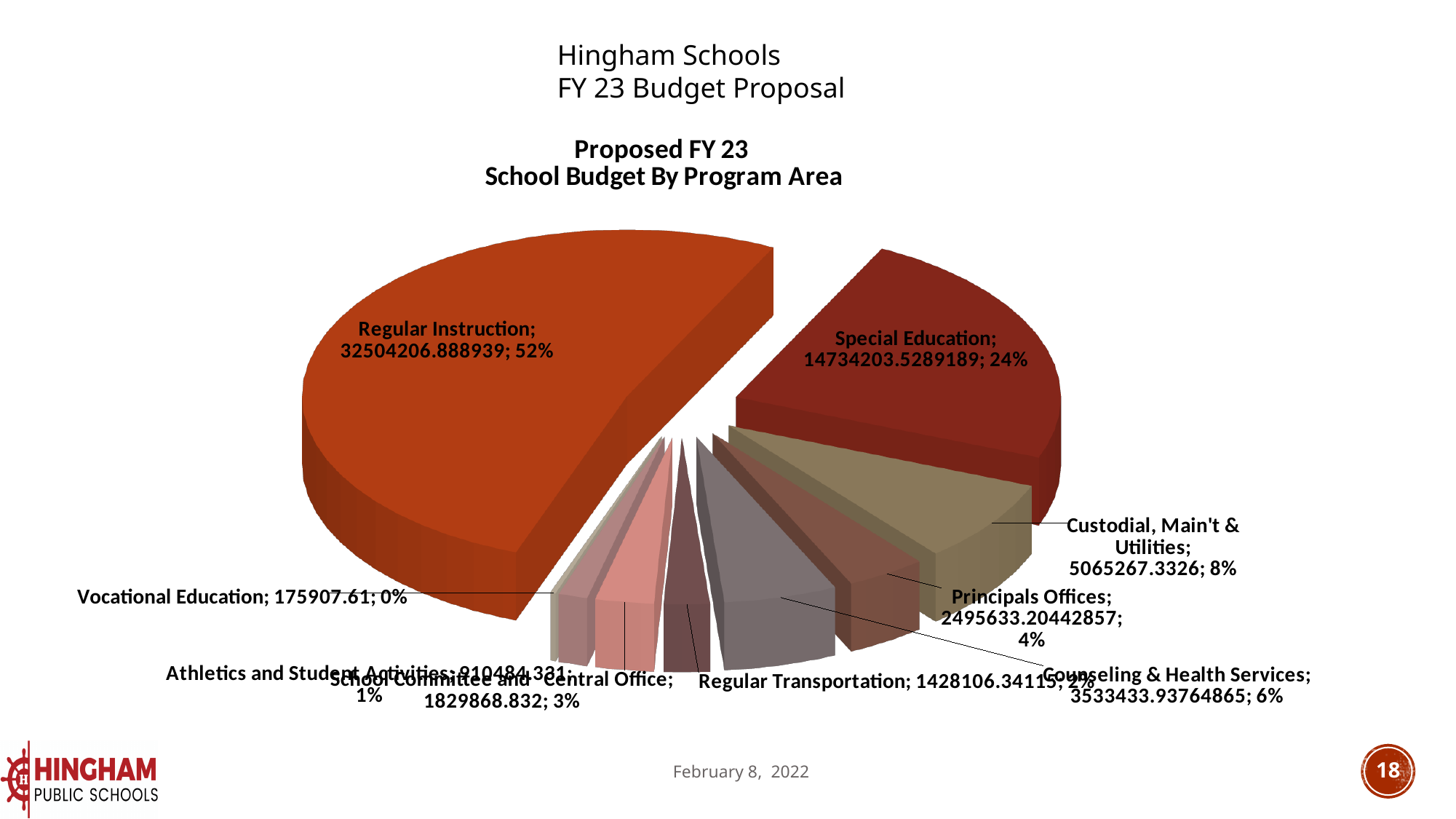
How many program areas (slices) are shown in the pie chart? 9 What share of the budget does Special Education represent? 24% What is the title of the chart? Proposed FY 23 School Budget By Program Area Which program area has the smallest share of the budget? Vocational Education What is the value shown for Regular Transportation? 1428106.34115 What share of the budget does Regular Instruction represent? 52% What is the difference in percentage points between the Regular Instruction share and the Special Education share? 28 What is the value shown for Principals Offices? 2495633.20442857 Which program area has the largest share of the budget? Regular Instruction What type of chart is shown on the slide? pie chart What is the value shown for Custodial, Main't & Utilities? 5065267.3326 Which is larger, the share for Counseling & Health Services or the share for Principals Offices? Counseling & Health Services